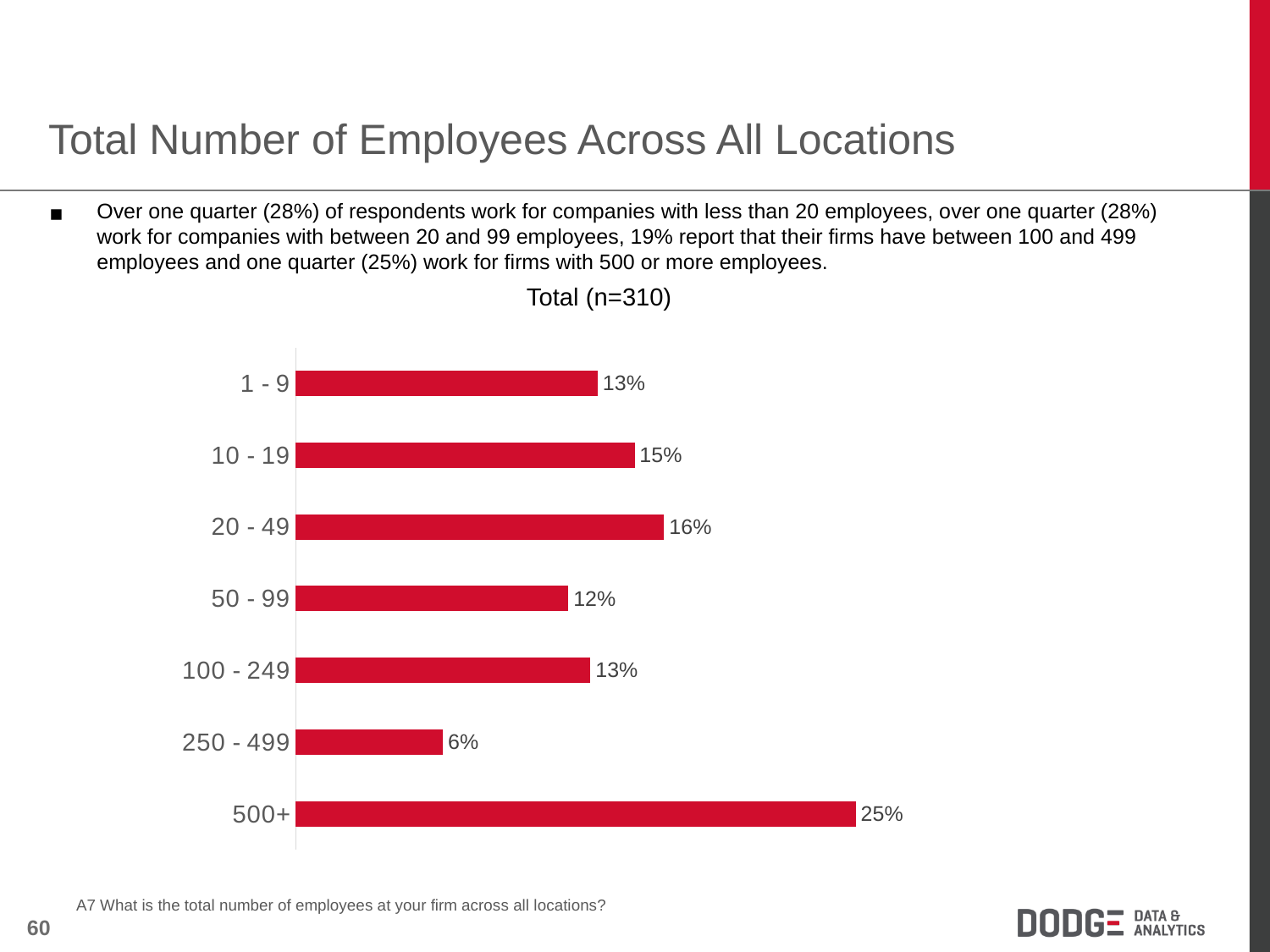
What is the value for the 20 - 49 category? 16% Which is larger, the value for 10 - 19 or the value for 50 - 99? 10 - 19 Which category has the highest value? 500+ What is the title of the chart? Total (n=310) What is the difference between the values for 500+ and 250 - 499? 19% What percentage of respondents work for firms with 500+ employees? 25% What is the value for the 10 - 19 category? 15% How many categories are shown in the chart? 7 What is the value for the 250 - 499 category? 6% What kind of chart is shown on the slide? Bar chart Which category has the lowest value? 250 - 499 What is the difference between the values for 20 - 49 and 50 - 99? 4%